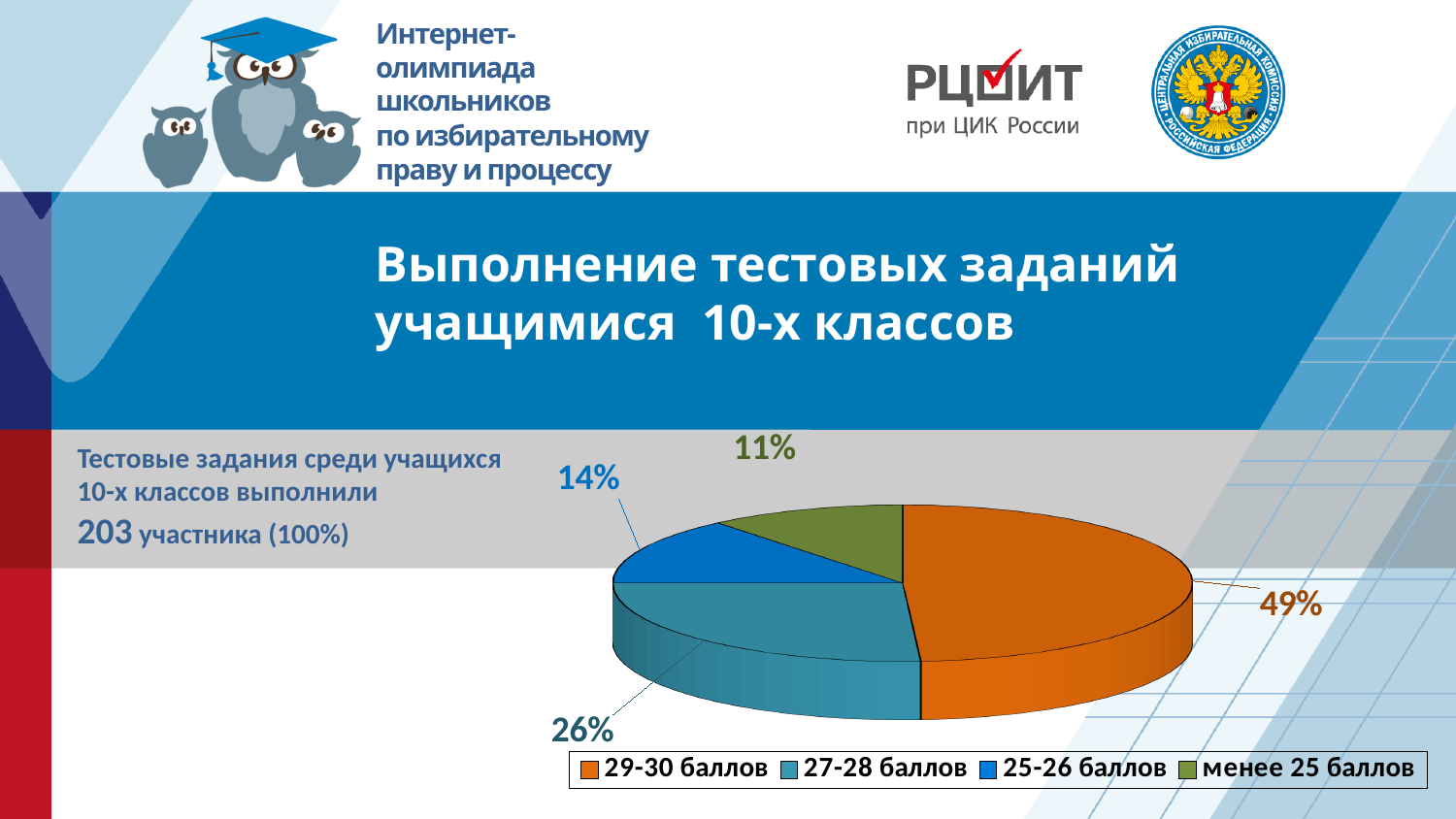
What share of the pie does the "29-30 баллов" slice have? 49% What kind of chart is shown on the slide? pie chart Which slice is larger: "25-26 баллов" or "менее 25 баллов"? 25-26 баллов What share of the pie does the "27-28 баллов" slice have? 26% What share of the pie does the "25-26 баллов" slice have? 14% Which category has the largest slice of the pie? 29-30 баллов What is the difference in percentage points between the "29-30 баллов" slice and the "27-28 баллов" slice? 23 What colour is the "29-30 баллов" slice in the pie chart? orange How many entries does the legend list? 4 How many slices does the pie chart have? 4 Which category has the smallest slice of the pie? менее 25 баллов